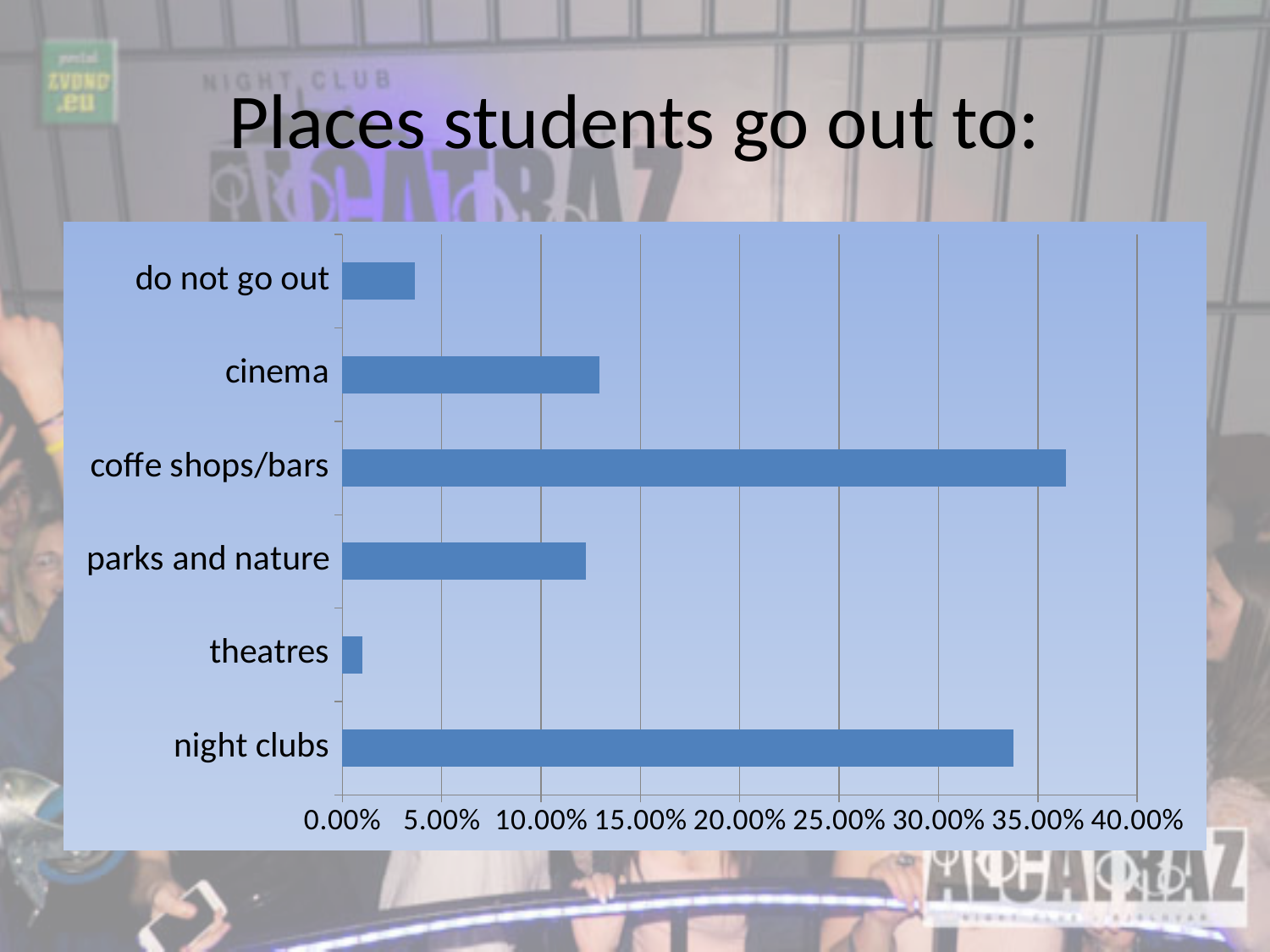
Which is larger, the value for night clubs or the value for parks and nature? night clubs Is the value for theatres greater or less than 5.00%? less Is the value for night clubs greater or less than 30.00%? greater Which is larger, the value for cinema or the value for do not go out? cinema Is the value for coffe shops/bars greater or less than 35.00%? greater How many categories are shown in the chart? 6 Which category has the highest value? coffe shops/bars What is the title of the slide's chart? Places students go out to: Which category has the lowest value? theatres What kind of chart is shown on the slide? bar chart